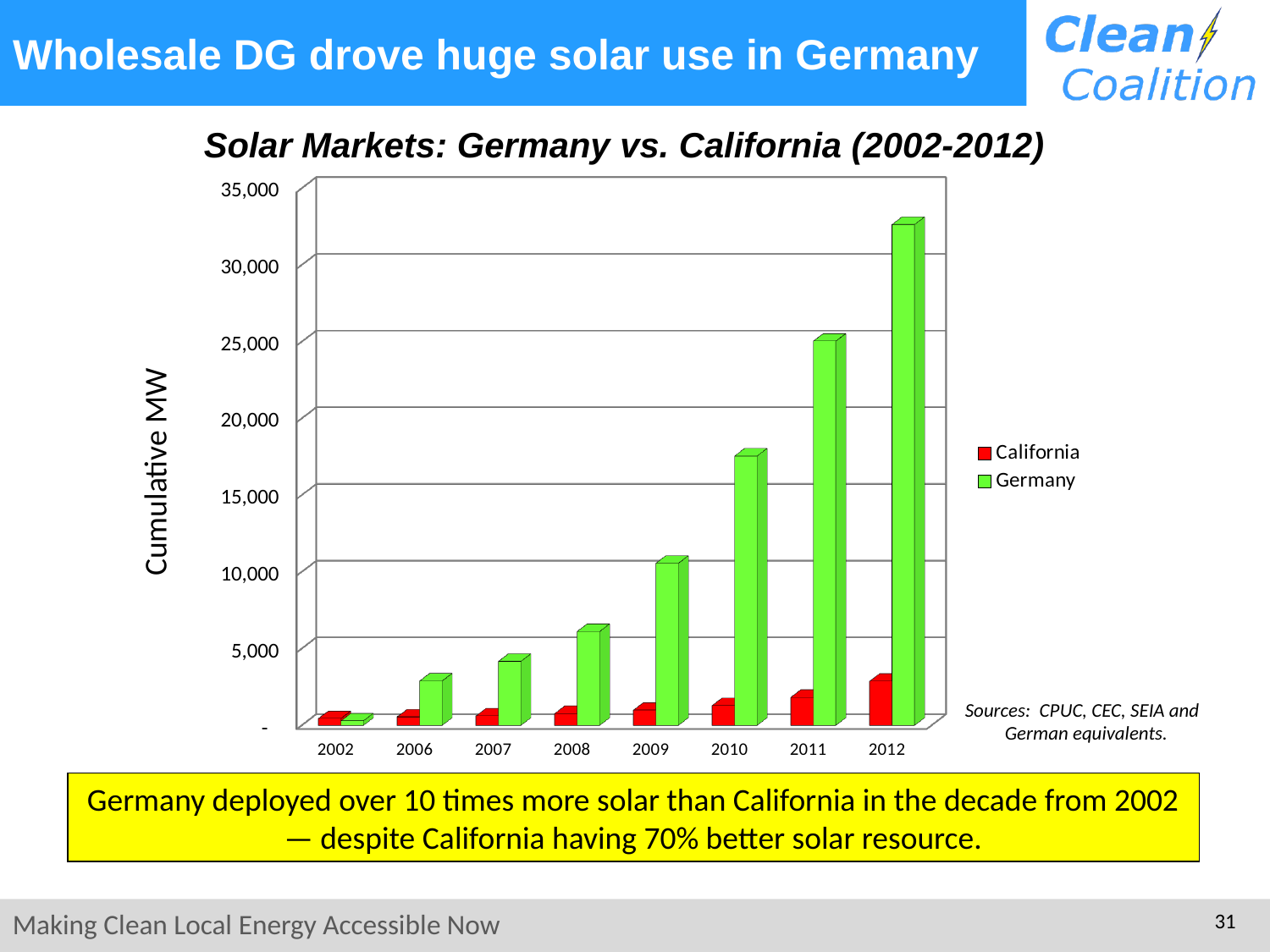
Is the Germany value for 2012 greater or less than 30,000? greater Is the Germany value for 2007 greater or less than 5,000? less Is the California value for 2012 greater or less than 5,000? less How many series does the legend list? 2 In 2012, which is larger, the Germany value or the California value? Germany In which year is the Germany bar lowest? 2002 In which year is the Germany bar highest? 2012 Do the Germany values rise or fall from 2002 to 2012? rise What is the label on the y axis of the chart? Cumulative MW What kind of chart is shown on the slide? bar chart How many years are shown along the x axis? 8